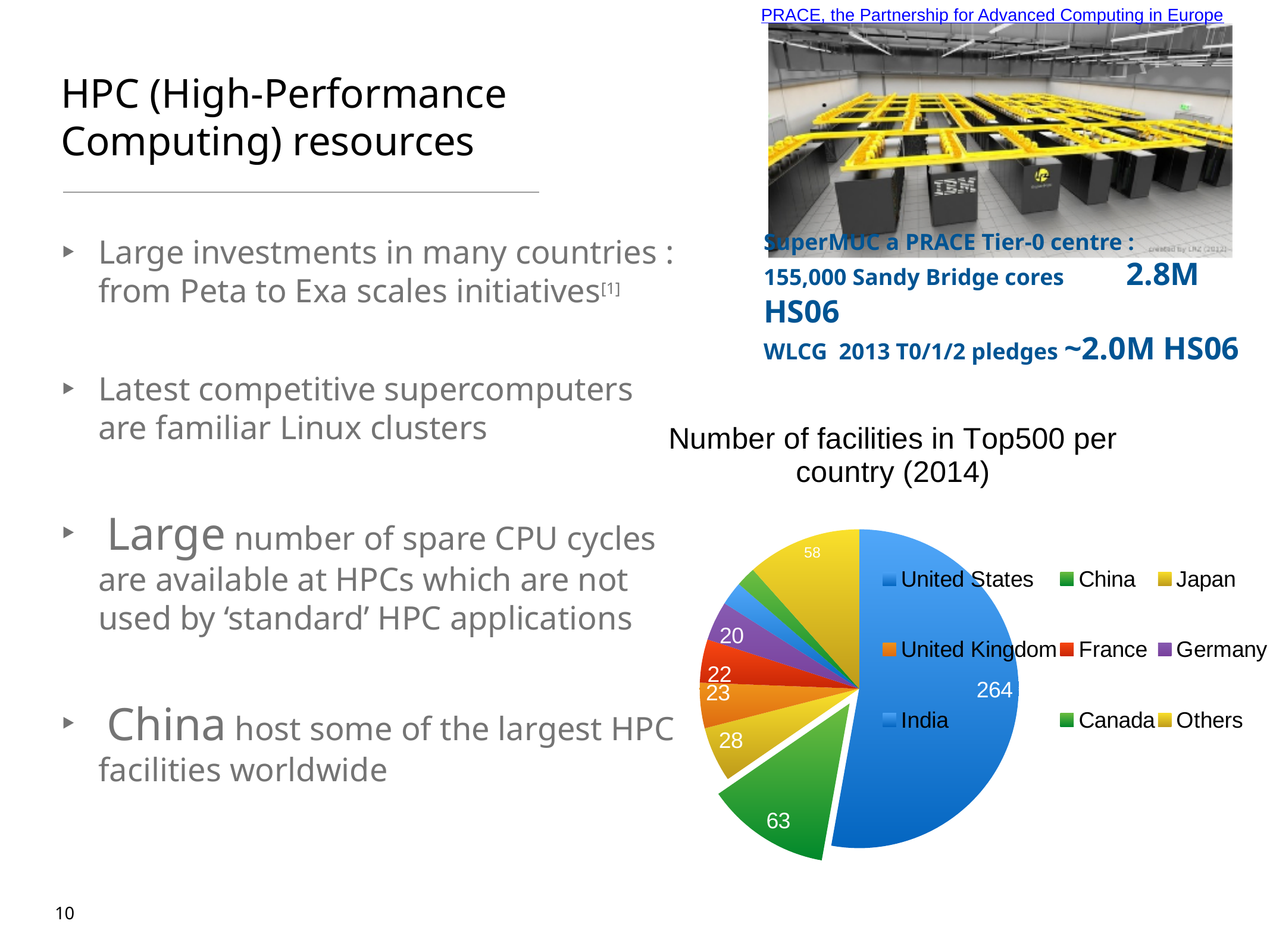
What is the difference between the number of facilities for the United States and China in the pie chart? 201 Which country has the largest number of facilities in the Top500 pie chart? United States What kind of chart is shown on the slide? pie chart How many categories does the legend of the pie chart list? 9 How many Top500 facilities does China have according to the pie chart? 63 What is the title of the pie chart? Number of facilities in Top500 per country (2014) Which slice of the pie chart is pulled out (exploded) from the rest? China Which has more Top500 facilities in the pie chart, China or the United States? United States How many Top500 facilities does the United States have according to the pie chart? 264 How many Top500 facilities does Germany have according to the pie chart? 20